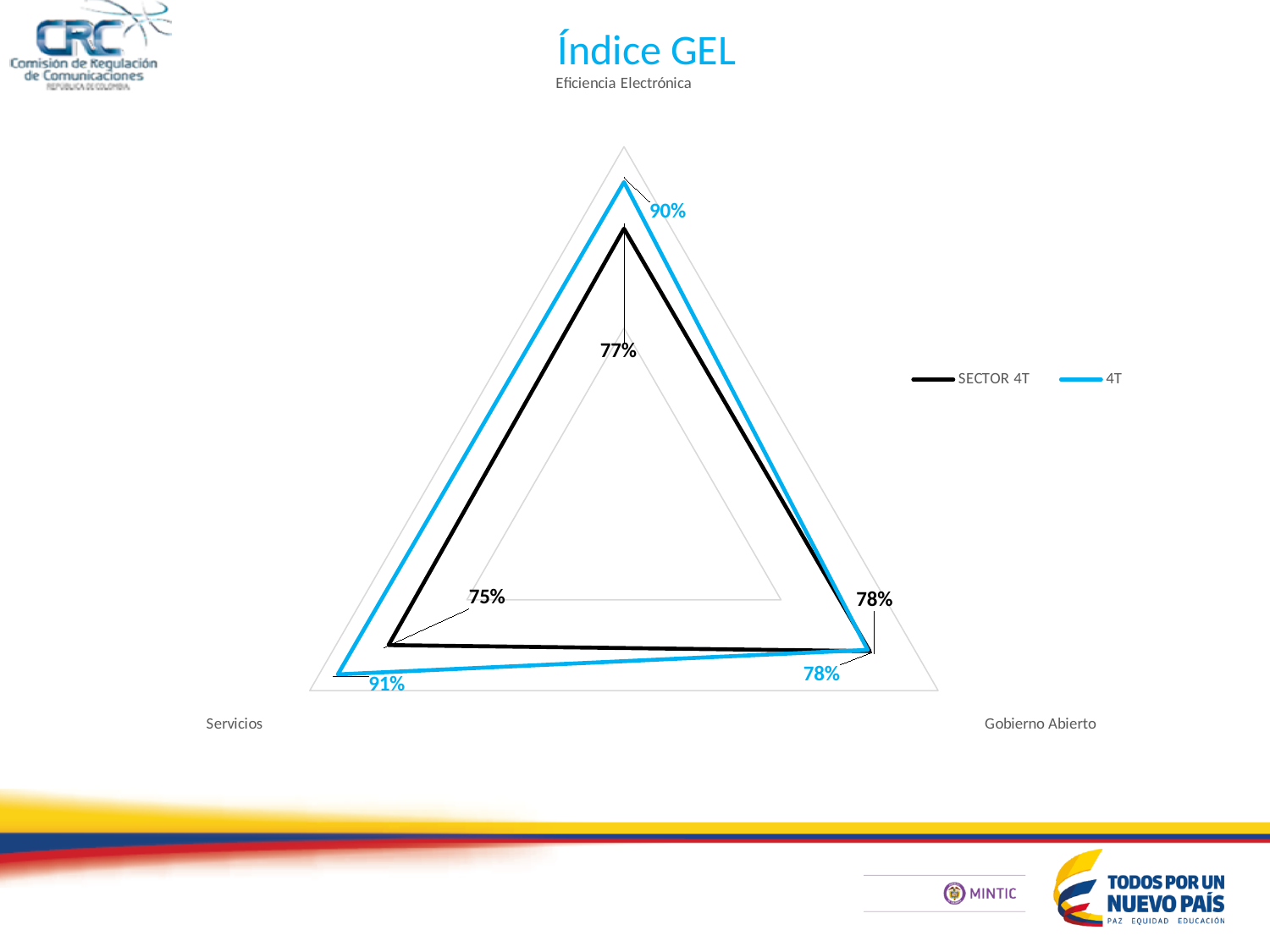
On which axis does the 4T series reach its highest value? Servicios What kind of chart is shown on the slide? Radar chart On which axis does the SECTOR 4T series have its lowest value? Servicios Which series has the larger value for Eficiencia Electrónica, 4T or SECTOR 4T? 4T What is the value of the SECTOR 4T series for Servicios? 75% How many series does the legend list? 2 What is the value of the SECTOR 4T series for Gobierno Abierto? 78% What is the value of the 4T series for Eficiencia Electrónica? 90% What is the difference between the 4T and SECTOR 4T values for Servicios? 16% How many axes (categories) does the radar chart have? 3 What is the value of the SECTOR 4T series for Eficiencia Electrónica? 77% What is the value of the 4T series for Servicios? 91%